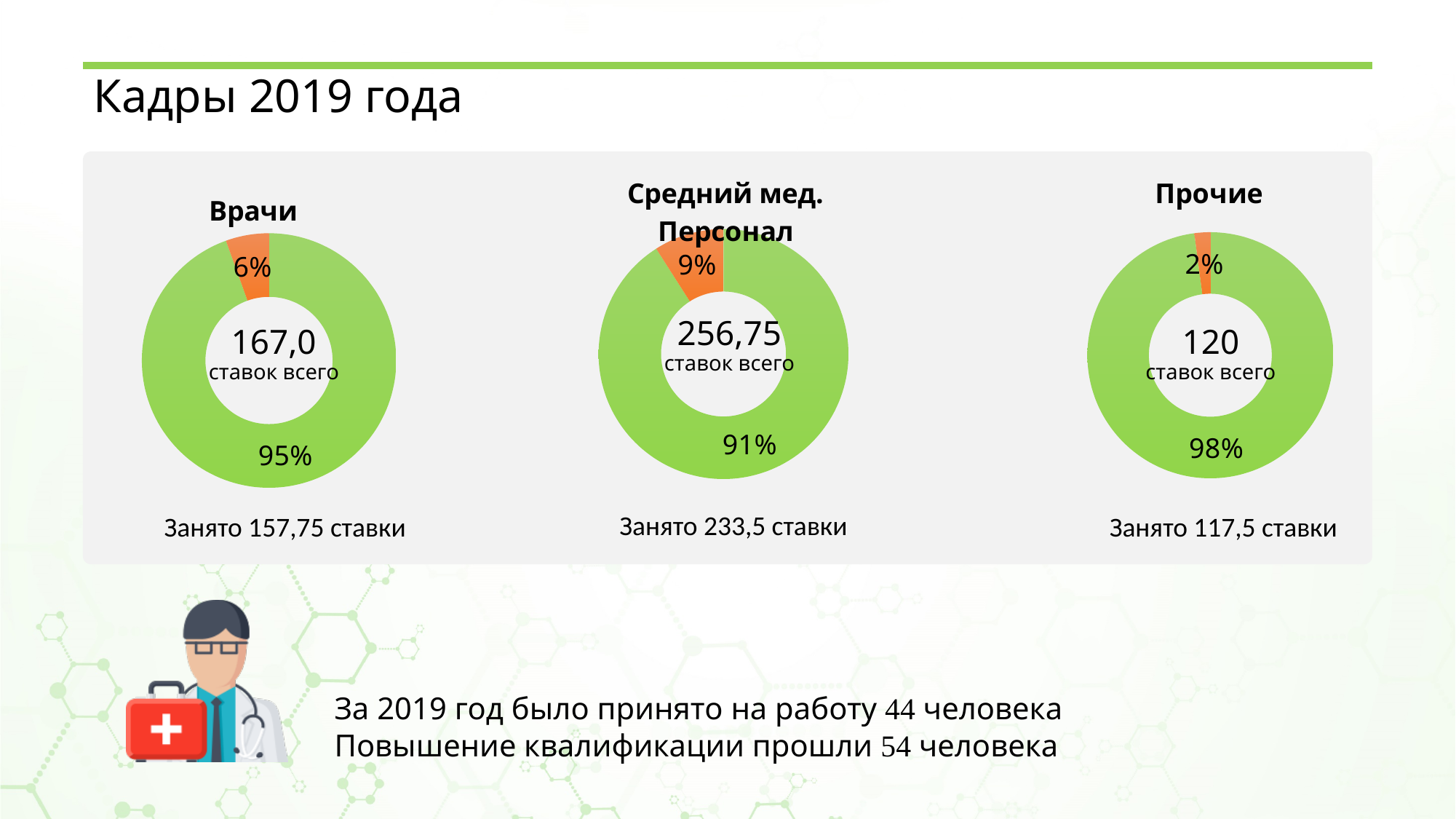
What is the total number of positions (ставок всего) shown in the centre of the "Прочие" chart? 120 In the "Врачи" chart, what percentage is shown for the orange segment? 6% In the "Врачи" chart, what percentage is shown for the green segment? 95% In the "Средний мед. Персонал" chart, what percentage is shown for the orange segment? 9% Which of the three charts shows the smallest orange (unfilled) share? Прочие In the "Прочие" chart, what is the difference between the total positions (120) and the occupied positions (117,5)? 2,5 In the "Прочие" chart, what percentage is shown for the green segment? 98% What is the total number of positions (ставок всего) shown in the centre of the "Средний мед. Персонал" chart? 256,75 How many donut charts are shown on the slide? 3 How many positions are occupied (Занято) according to the "Врачи" chart? 157,75 ставки Which of the three charts shows the largest orange (unfilled) share? Средний мед. Персонал What type of chart is used for the "Врачи" chart? Donut (pie) chart